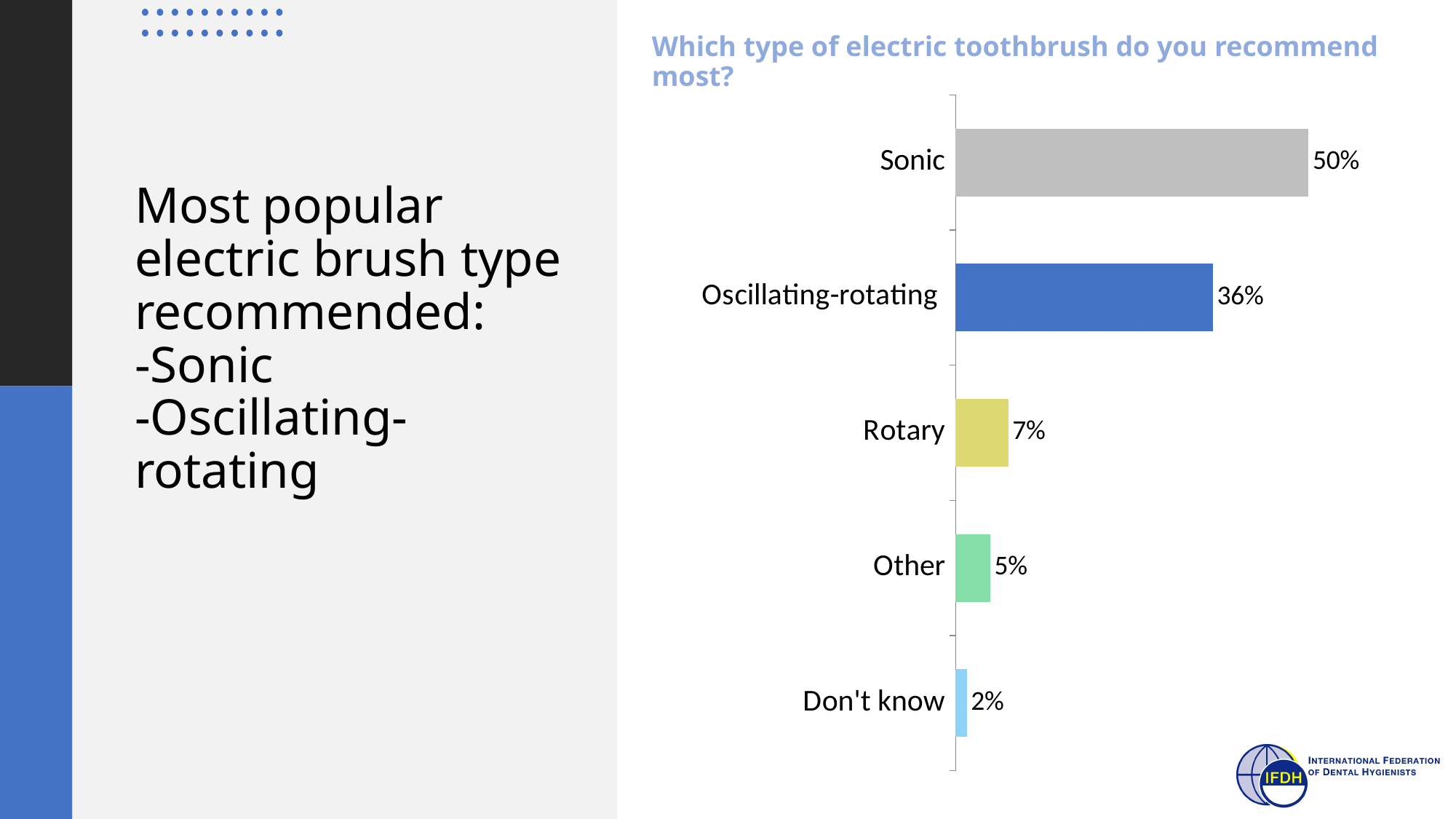
Which category has the lowest value in the chart? Don't know Which has a larger value, Rotary or Other? Rotary Which type of electric toothbrush has the highest recommendation percentage? Sonic What is the value for the Don't know category? 2% How many categories are shown in the chart? 5 What is the title of the chart? Which type of electric toothbrush do you recommend most? What percentage is shown for Rotary? 7% What is the difference between the Rotary and Other values? 2 What is the difference in percentage points between Sonic and Oscillating-rotating? 14 What kind of chart is shown on the slide? Bar chart What is the value shown for Oscillating-rotating? 36% What percentage of respondents recommend Sonic electric toothbrushes most? 50%